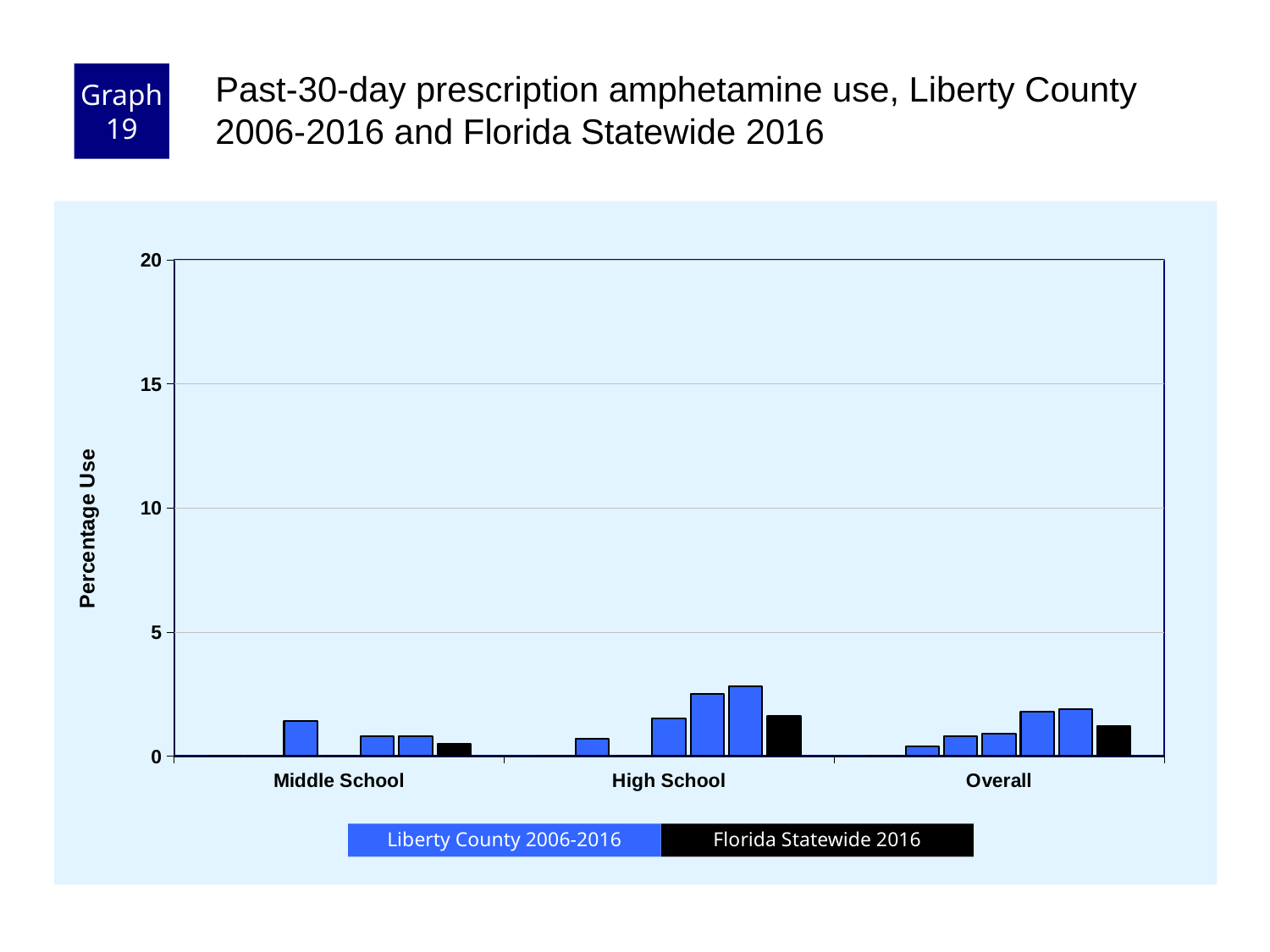
What kind of chart is shown on the slide? bar chart Is the Florida Statewide 2016 value for Overall greater or less than 10? less Is the tallest Liberty County 2006-2016 bar for High School greater or less than 5? less What is the label of the y axis? Percentage Use How many series does the legend list? 2 Is the Florida Statewide 2016 value for High School greater or less than 5? less What colour are the Florida Statewide 2016 bars? black Which category has the highest Florida Statewide 2016 value? High School Which category has the higher Florida Statewide 2016 value, Middle School or High School? High School Which category has the lowest Florida Statewide 2016 value? Middle School How many categories are shown along the x axis? 3